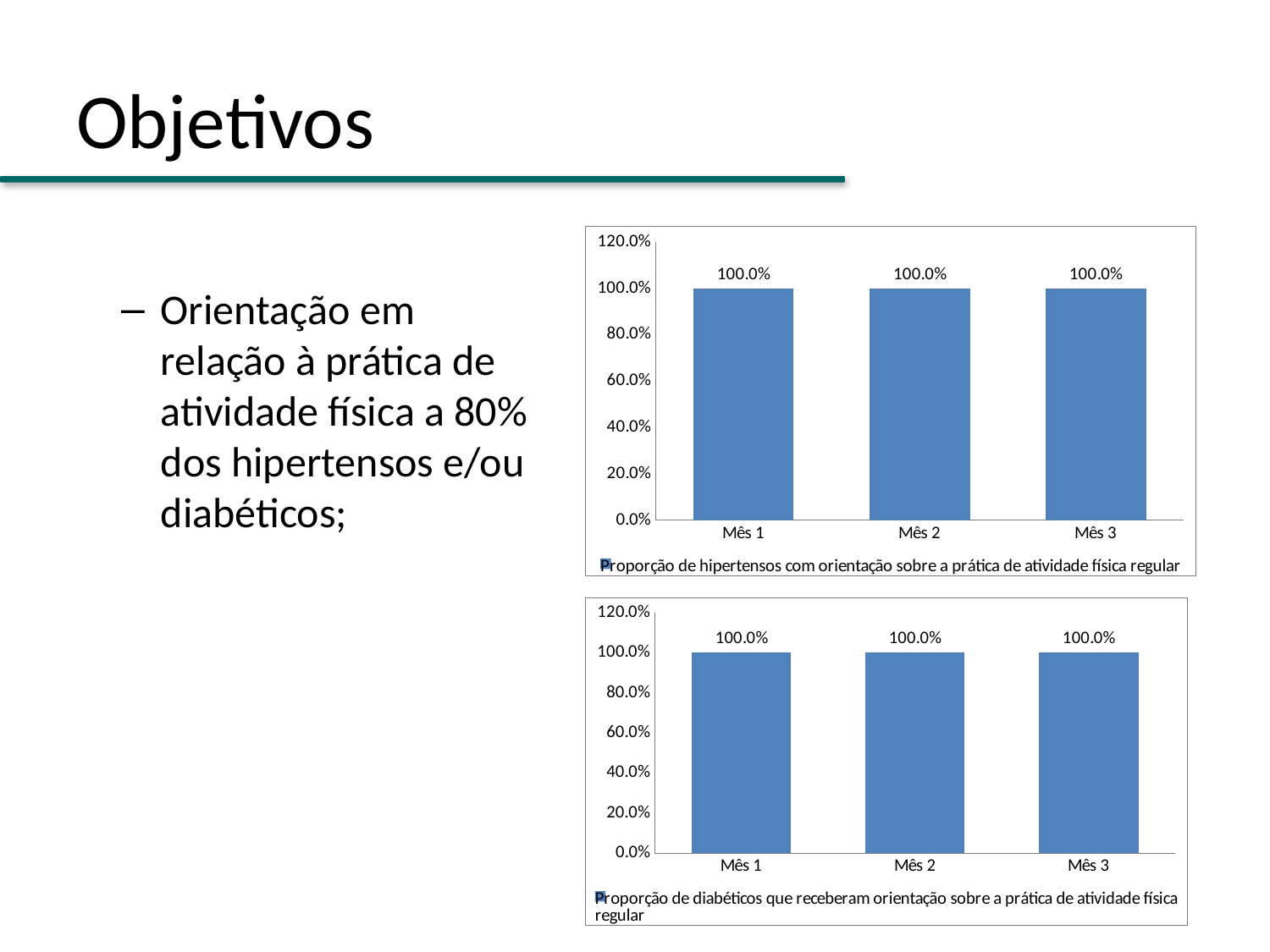
In the bottom chart, what is the value for Mês 2? 100.0% How many series does the legend of the bottom chart list? 1 What kind of chart is the top chart? bar chart In the top chart, what is the value for Mês 3? 100.0% How many bars are plotted in the bottom chart? 3 In the top chart, what is the value for Mês 1? 100.0% In the bottom chart, what is the difference between the values for Mês 1 and Mês 3? 0.0% In the bottom chart, what is the value for Mês 3? 100.0% What is the legend entry of the bottom chart? Proporção de diabéticos que receberam orientação sobre a prática de atividade física regular In the top chart, is the value for Mês 2 greater or less than 80.0%? greater In the top chart, do the values rise, fall or stay the same from Mês 1 to Mês 3? stay the same How many categories are shown on the x axis of the top chart? 3